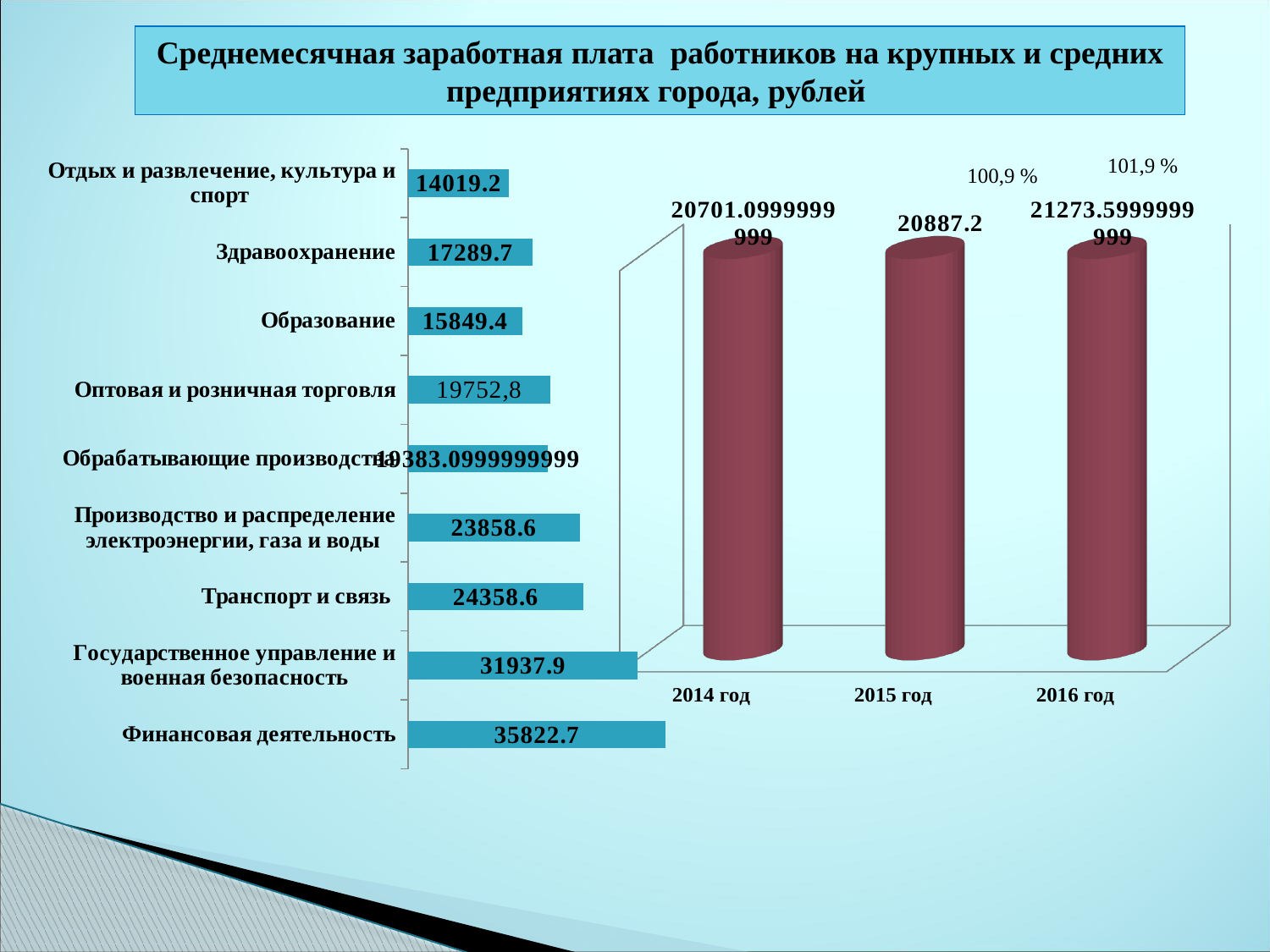
In the left bar chart, what is the value for Здравоохранение? 17289.7 In the left bar chart, what is the value for Транспорт и связь? 24358.6 What kind of chart is the chart on the left of the slide? Bar chart In the left bar chart, what is the difference between Финансовая деятельность and Государственное управление и военная безопасность? 3884.8 In the left bar chart, which category has the highest value? Финансовая деятельность How many categories are shown in the left bar chart? 9 In the left bar chart, which category has the lowest value? Отдых и развлечение, культура и спорт In the left bar chart, what is the value for Финансовая деятельность? 35822.7 In the left bar chart, which is larger: Здравоохранение or Образование? Здравоохранение In the left bar chart, what is the difference between Транспорт и связь and Производство и распределение электроэнергии, газа и воды? 500 In the right chart by year, do the values rise or fall from 2014 год to 2016 год? Rise In the right chart by year, what is the value for 2015 год? 20887.2